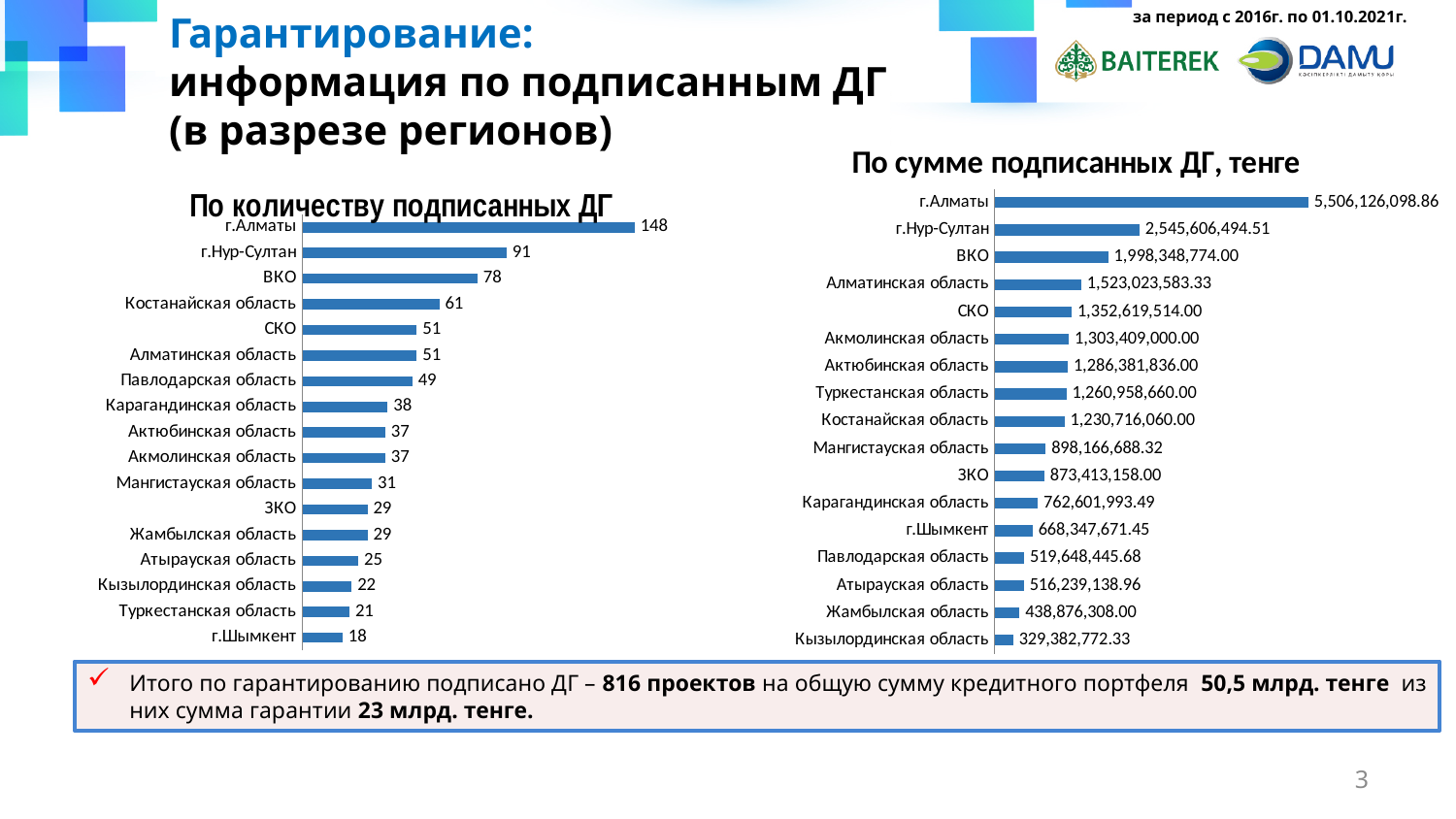
In the chart 'По количеству подписанных ДГ', which is larger: ВКО or Костанайская область? ВКО What type of chart is 'По сумме подписанных ДГ, тенге'? Bar chart In the chart 'По сумме подписанных ДГ, тенге', what is the value for г.Нур-Султан? 2,545,606,494.51 In the chart 'По количеству подписанных ДГ', what is the difference between г.Алматы and г.Нур-Султан? 57 In the chart 'По сумме подписанных ДГ, тенге', what is the difference between г.Алматы and г.Нур-Султан? 2,960,519,604.35 In the chart 'По сумме подписанных ДГ, тенге', which region has the highest value? г.Алматы In the chart 'По количеству подписанных ДГ', which region has the lowest value? г.Шымкент In the chart 'По количеству подписанных ДГ', what is the value for Павлодарская область? 49 In the chart 'По количеству подписанных ДГ', what is the value for г.Алматы? 148 In the chart 'По сумме подписанных ДГ, тенге', which is larger: Мангистауская область or ЗКО? Мангистауская область In the chart 'По количеству подписанных ДГ', how many regions are shown? 17 In the chart 'По сумме подписанных ДГ, тенге', what is the value for Кызылординская область? 329,382,772.33